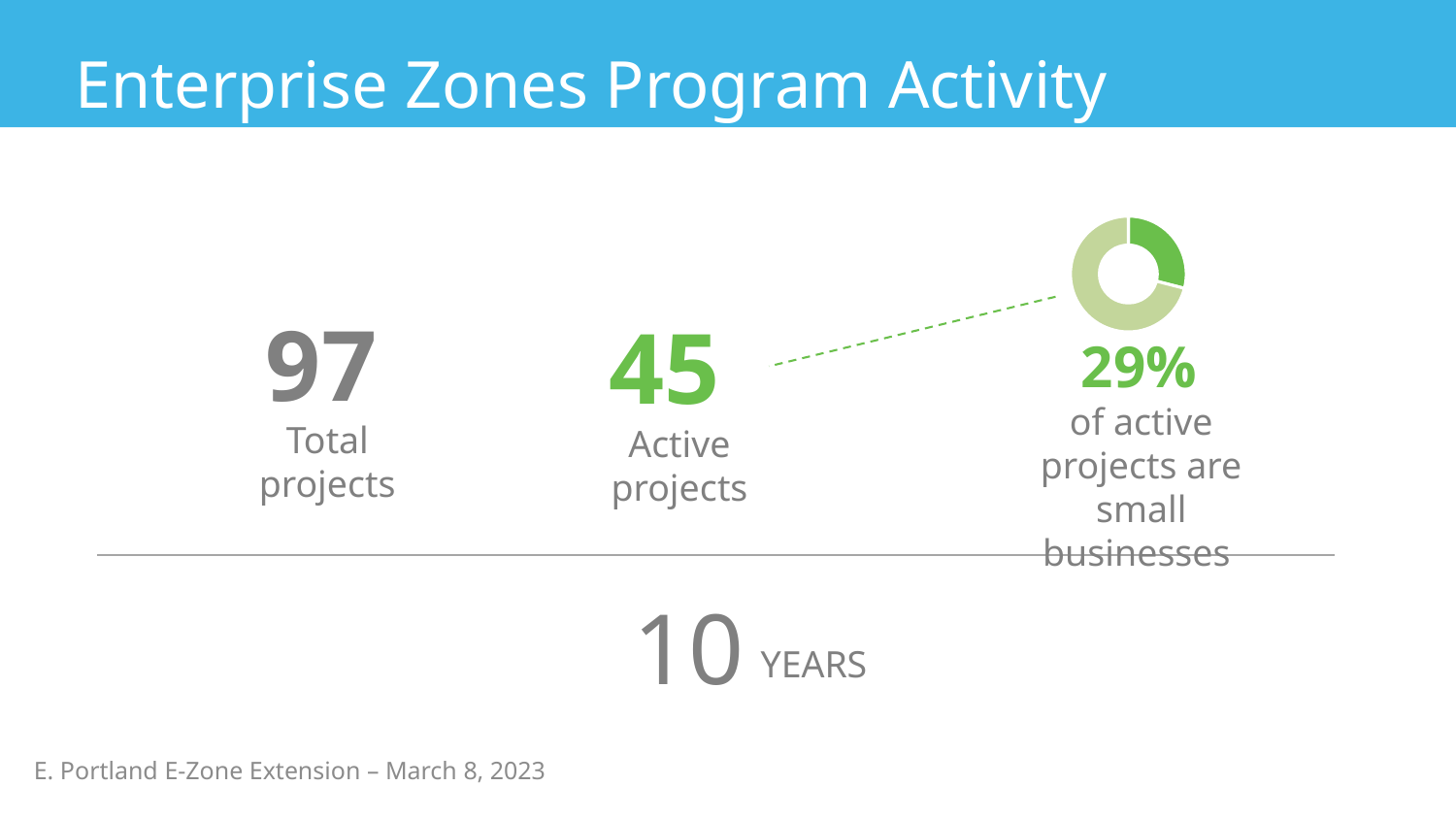
Is the share represented by the dark green slice of the donut chart greater or less than 50%? less What colour is the donut chart slice that represents small businesses? Dark green Based on the donut chart, what percentage of active projects are not small businesses? 71% According to the donut chart, what percentage of active projects are small businesses? 29% How many slices does the donut chart have? 2 What kind of chart is shown on the slide? Donut (pie) chart What is the title of the slide containing the donut chart? Enterprise Zones Program Activity How many total projects does the slide report? 97 How many active projects does the slide report, which the donut chart's 29% refers to? 45 Which slice of the donut chart is larger, the dark green slice or the light green slice? The light green slice